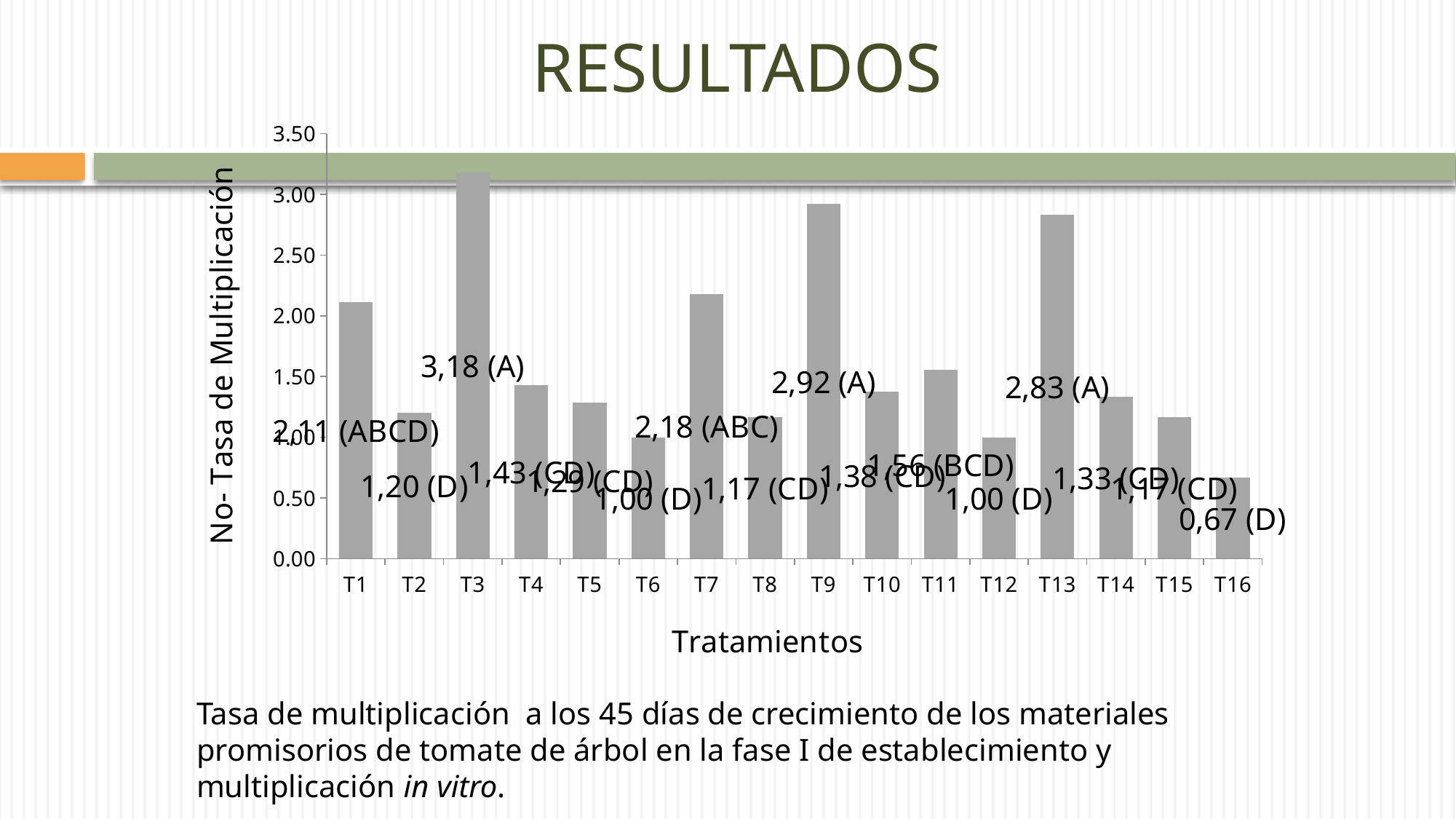
Which treatment has the highest multiplication rate? T3 What is the title of the x axis? Tratamientos What is the multiplication rate value labelled for T3? 3,18 Is the value for T12 greater or less than 1.50? less What is the multiplication rate value labelled for T16? 0,67 What kind of chart is shown on the slide? bar chart What is the multiplication rate value labelled for T13? 2,83 Which has the larger value, T1 or T7? T7 How many treatments (categories) are plotted on the x axis? 16 What is the difference between the values for T3 and T9? 0,26 What is the multiplication rate value labelled for T9? 2,92 Which treatment has the lowest multiplication rate? T16